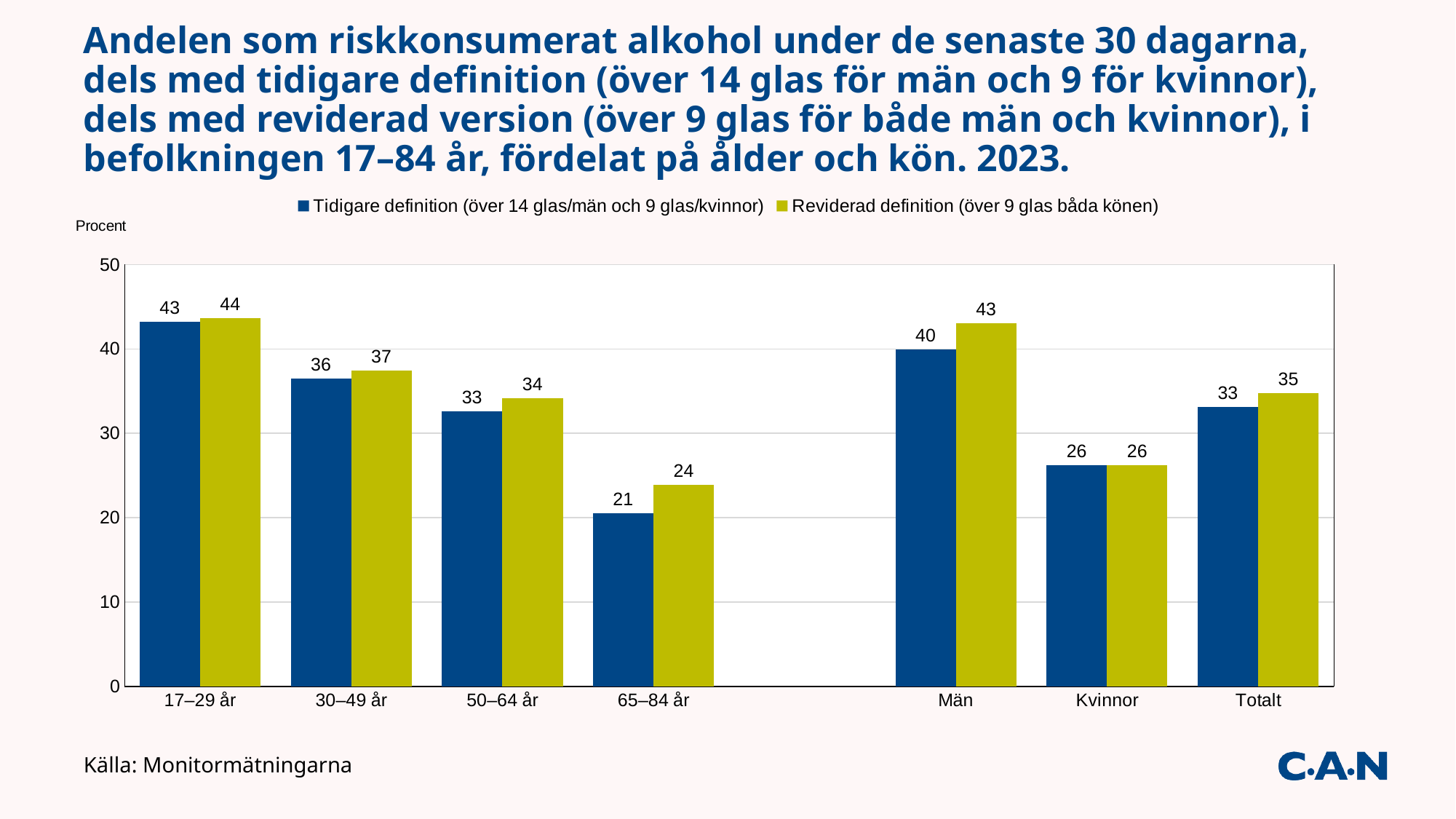
What is the label on the y axis? Procent What is the value for 65–84 år under Reviderad definition (över 9 glas båda könen)? 24 Which category has the lowest value under Tidigare definition (över 14 glas/män och 9 glas/kvinnor)? 65–84 år Which is larger: the Tidigare definition value for 30–49 år or for Totalt? 30–49 år How many categories are shown on the x axis? 7 How many series does the legend list? 2 What is the difference between the Tidigare definition values for Män and Kvinnor? 14 What is the value for 17–29 år under Tidigare definition (över 14 glas/män och 9 glas/kvinnor)? 43 Which category has the highest value under Reviderad definition (över 9 glas båda könen)? 17–29 år What kind of chart is shown on the slide? Bar chart What is the difference between the Reviderad definition and Tidigare definition values for 65–84 år? 3 What is the value for Kvinnor under Reviderad definition (över 9 glas båda könen)? 26